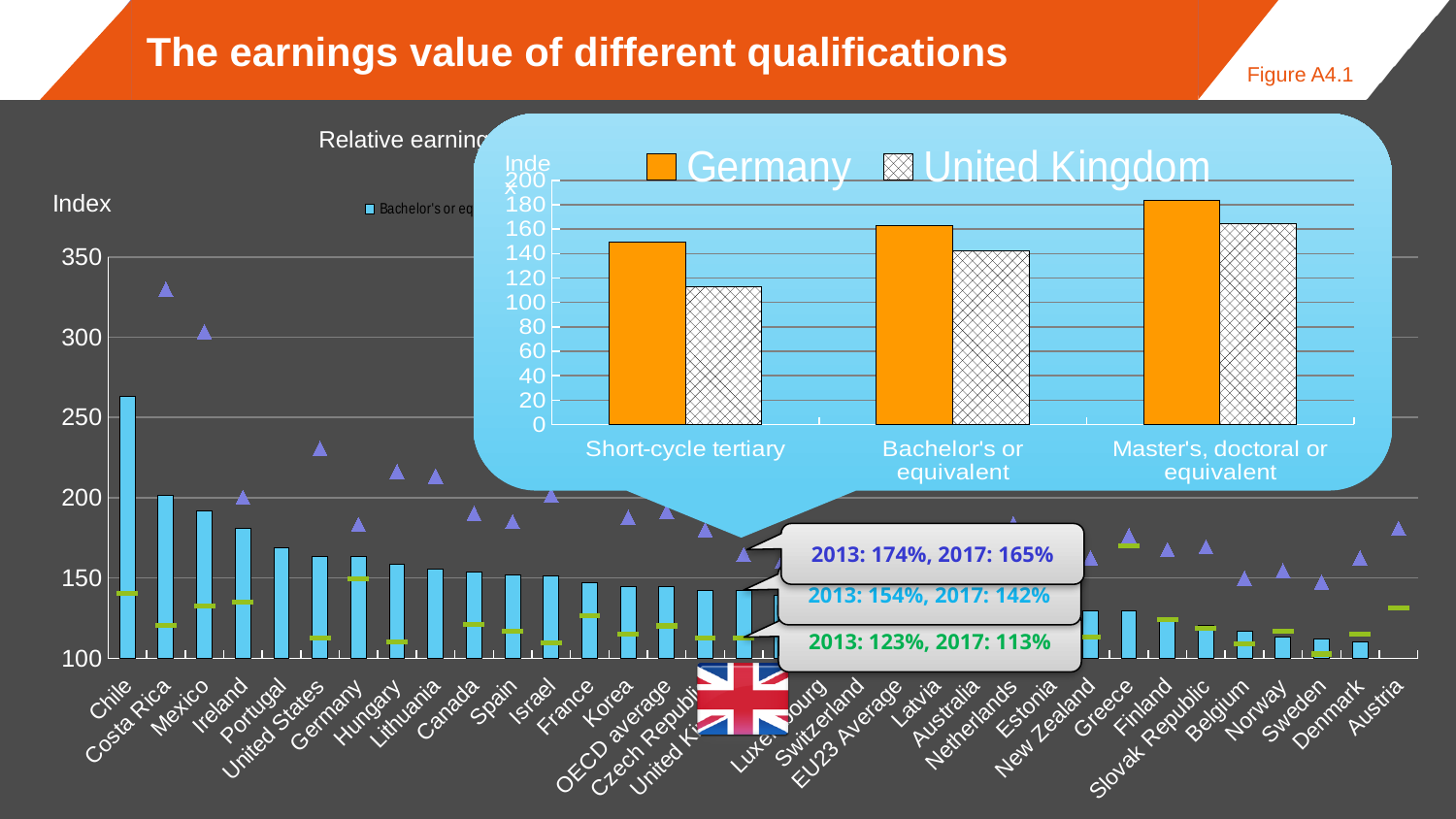
In the large background chart of countries, is the bar for Chile greater or less than 250? greater In the large background chart of countries, do the bar values rise or fall from left to right along the x axis? fall How many series does the legend of the inset Germany/United Kingdom chart list? 2 How many qualification categories are shown on the x axis of the inset Germany/United Kingdom chart? 3 In the inset Germany/United Kingdom chart, is the Germany value for Short-cycle tertiary greater or less than 140? greater In the inset Germany/United Kingdom chart, is the United Kingdom value for Bachelor's or equivalent greater or less than 160? less In the inset Germany/United Kingdom chart, which series has the higher value for Short-cycle tertiary? Germany In the inset Germany/United Kingdom chart, for which category is the Germany value highest? Master's, doctoral or equivalent In the large background chart of countries, which has the taller bar, Chile or Austria? Chile In the large background chart of countries, which country has the highest bar? Chile What kind of chart is the inset chart comparing Germany and the United Kingdom? bar chart